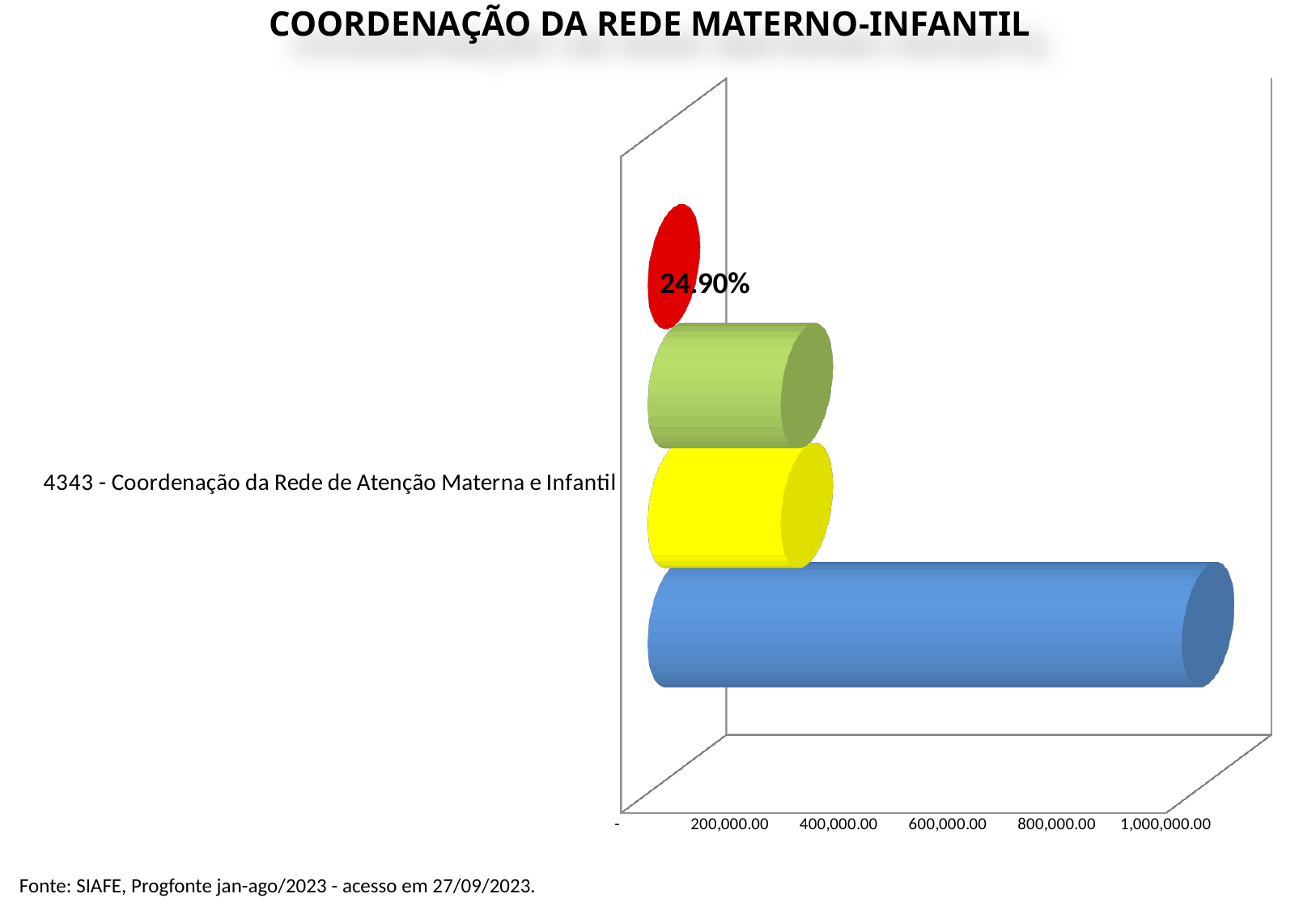
How many categories are shown on the vertical axis of the chart? 1 Is the value of the green bar greater or less than 600,000.00? less Which coloured bar is the longest on the chart? Blue Which is larger, the blue bar or the yellow bar? Blue bar Which coloured bar is the shortest on the chart? Red What is the name of the category shown on the chart? 4343 - Coordenação da Rede de Atenção Materna e Infantil Is the value of the blue bar greater or less than 800,000.00? greater What is the title of the chart? COORDENAÇÃO DA REDE MATERNO-INFANTIL What kind of chart is shown on the slide? Bar chart What percentage value is printed as a data label on the chart? 24.90% What is the highest tick value shown on the horizontal axis? 1,000,000.00 Is the value of the yellow bar greater or less than 600,000.00? less